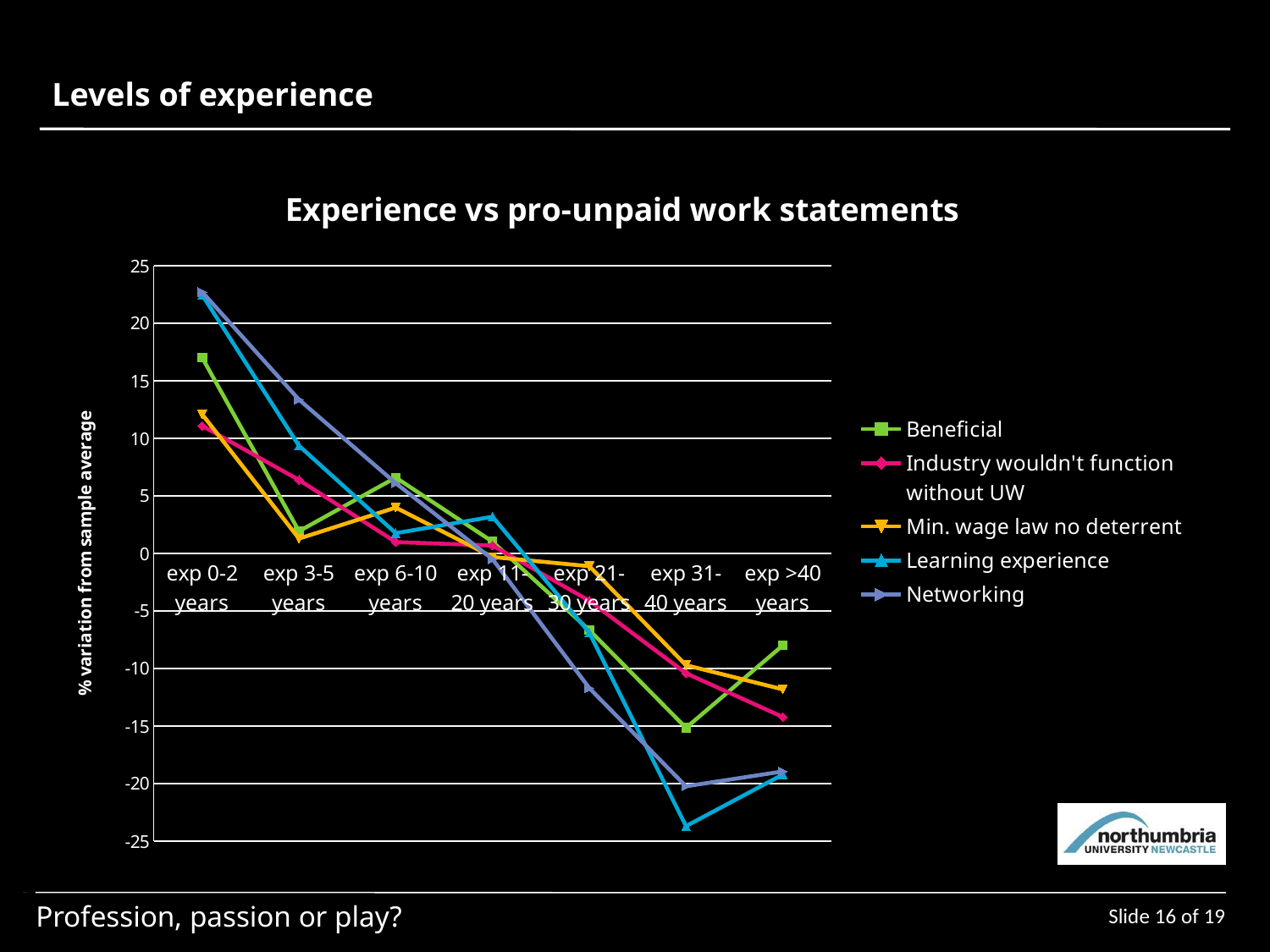
Is the value for Beneficial at exp 31-40 years greater or less than -10? less At exp 0-2 years, which is higher: Beneficial or Min. wage law no deterrent? Beneficial Is the value for Networking at exp 3-5 years greater or less than 10? greater Does the 'Industry wouldn't function without UW' line rise or fall as experience increases along the x axis? fall What kind of chart is shown on the slide? line chart Is the value for Learning experience at exp 31-40 years greater or less than -20? less How many series does the legend list? 5 How many experience categories are plotted along the x axis? 7 Which series has the lowest value at exp 31-40 years? Learning experience For the Networking series, which experience category has the highest value? exp 0-2 years What is the title of the chart? Experience vs pro-unpaid work statements